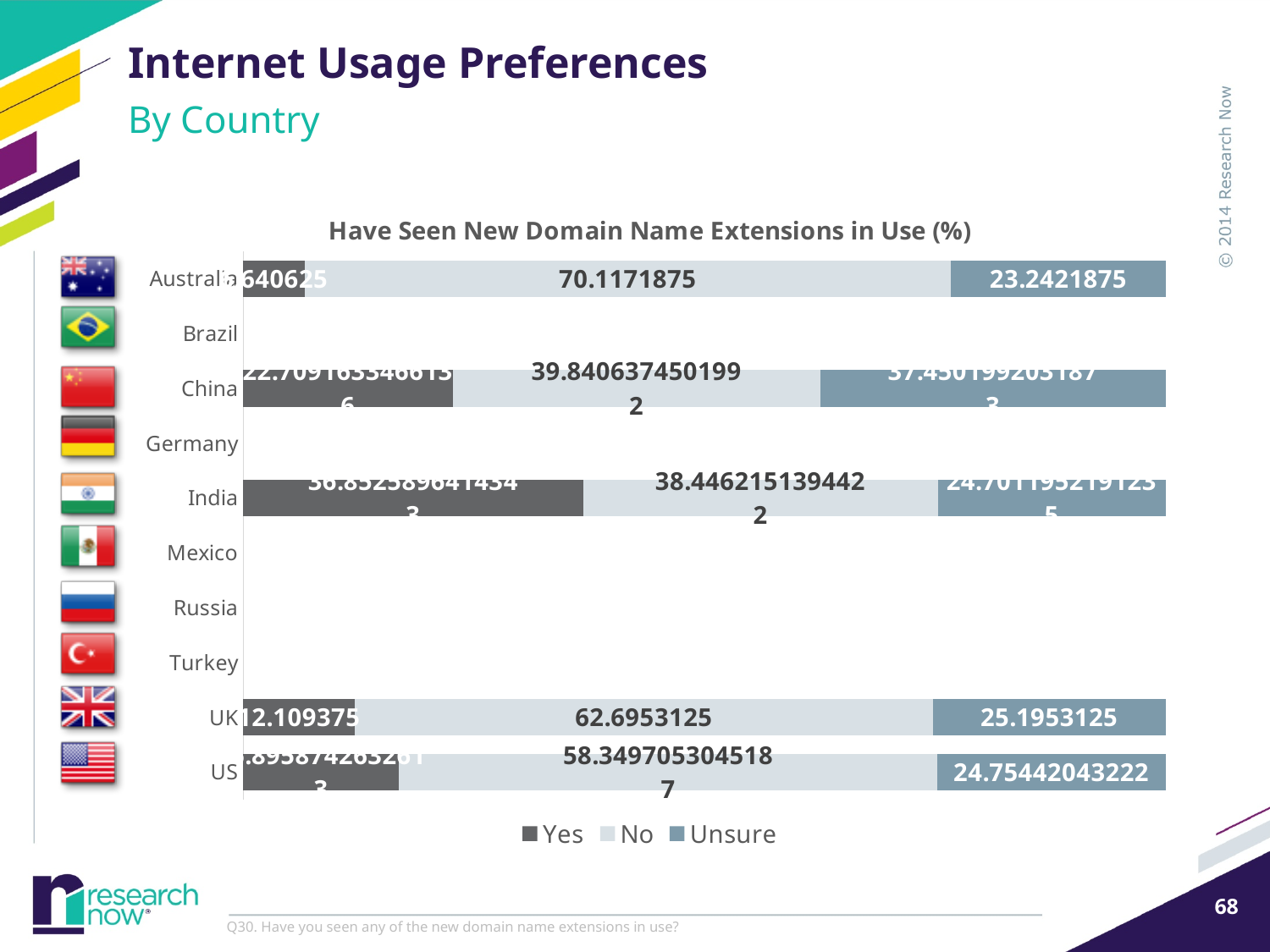
What is the 'No' value for the UK? 62.6953125 What kind of chart is shown on the slide? Stacked bar chart What is the total of the UK's stacked bar (Yes + No + Unsure)? 100 What is the 'No' value for Australia? 70.1171875 What is the 'Yes' value for the UK? 12.109375 What is the 'Unsure' value for Australia? 23.2421875 What is the title of the chart? Have Seen New Domain Name Extensions in Use (%) Which is larger, the 'No' value for Australia or the 'No' value for the UK? Australia What is the difference between the 'No' and 'Unsure' values for the UK? 37.5 How many series does the legend list? 3 How many countries are listed on the chart's category axis? 10 What is the 'Unsure' value for the US? 24.75442043222